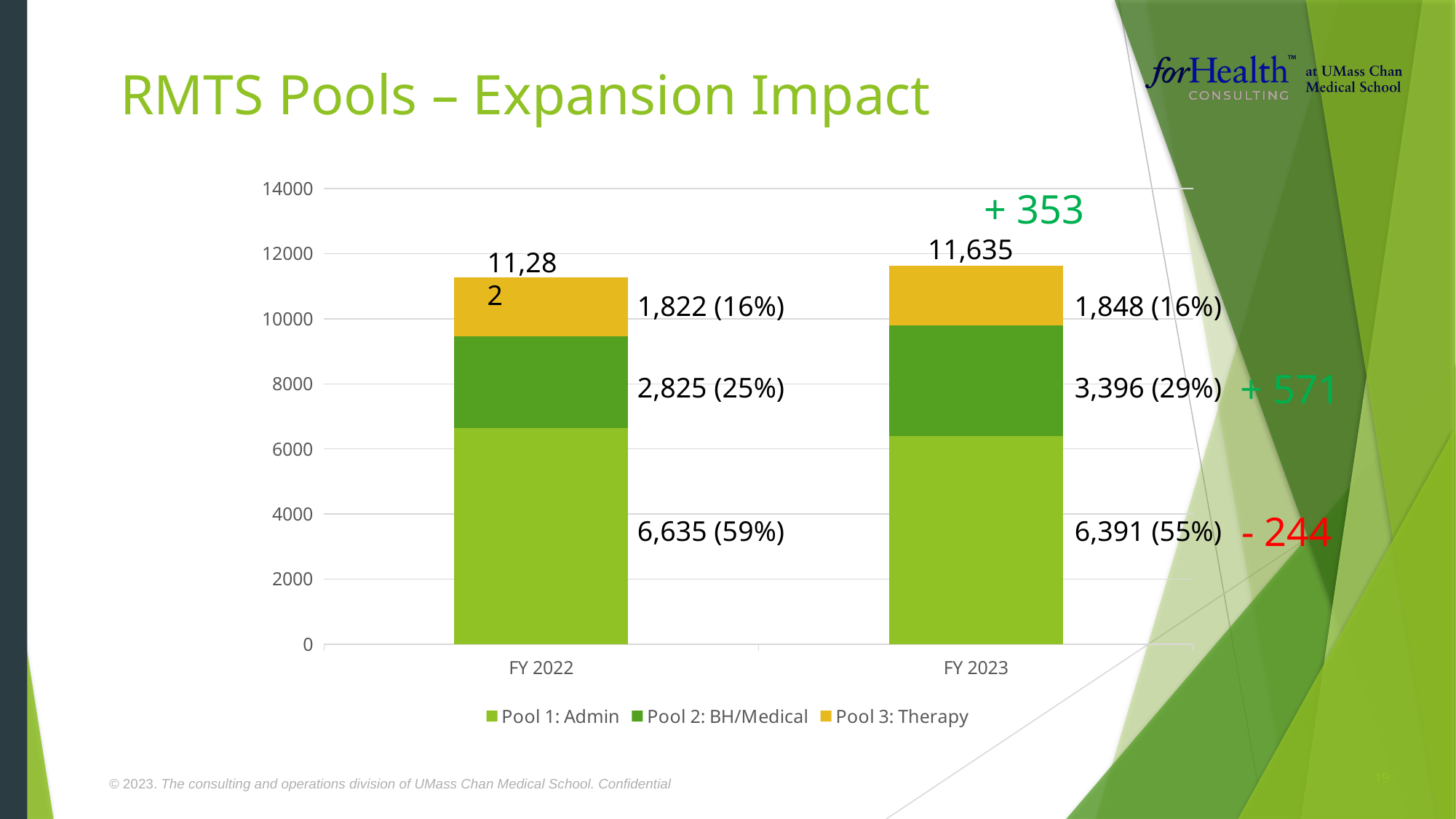
How many categories are shown on the x axis? 2 What is the title of the chart on the slide? RMTS Pools – Expansion Impact Which pool has the lowest value in FY 2023? Pool 3: Therapy What percentage share does Pool 1: Admin have in FY 2023? 55% What is the difference between Pool 2: BH/Medical in FY 2023 and FY 2022? 571 What kind of chart is shown on the slide? Stacked bar chart What is the value for Pool 1: Admin in FY 2022? 6,635 What is the total of the stacked bar for FY 2023? 11,635 Which is larger, Pool 1: Admin in FY 2022 or Pool 1: Admin in FY 2023? FY 2022 How many series does the legend list? 3 What is the value for Pool 3: Therapy in FY 2022? 1,822 What is the value for Pool 2: BH/Medical in FY 2023? 3,396